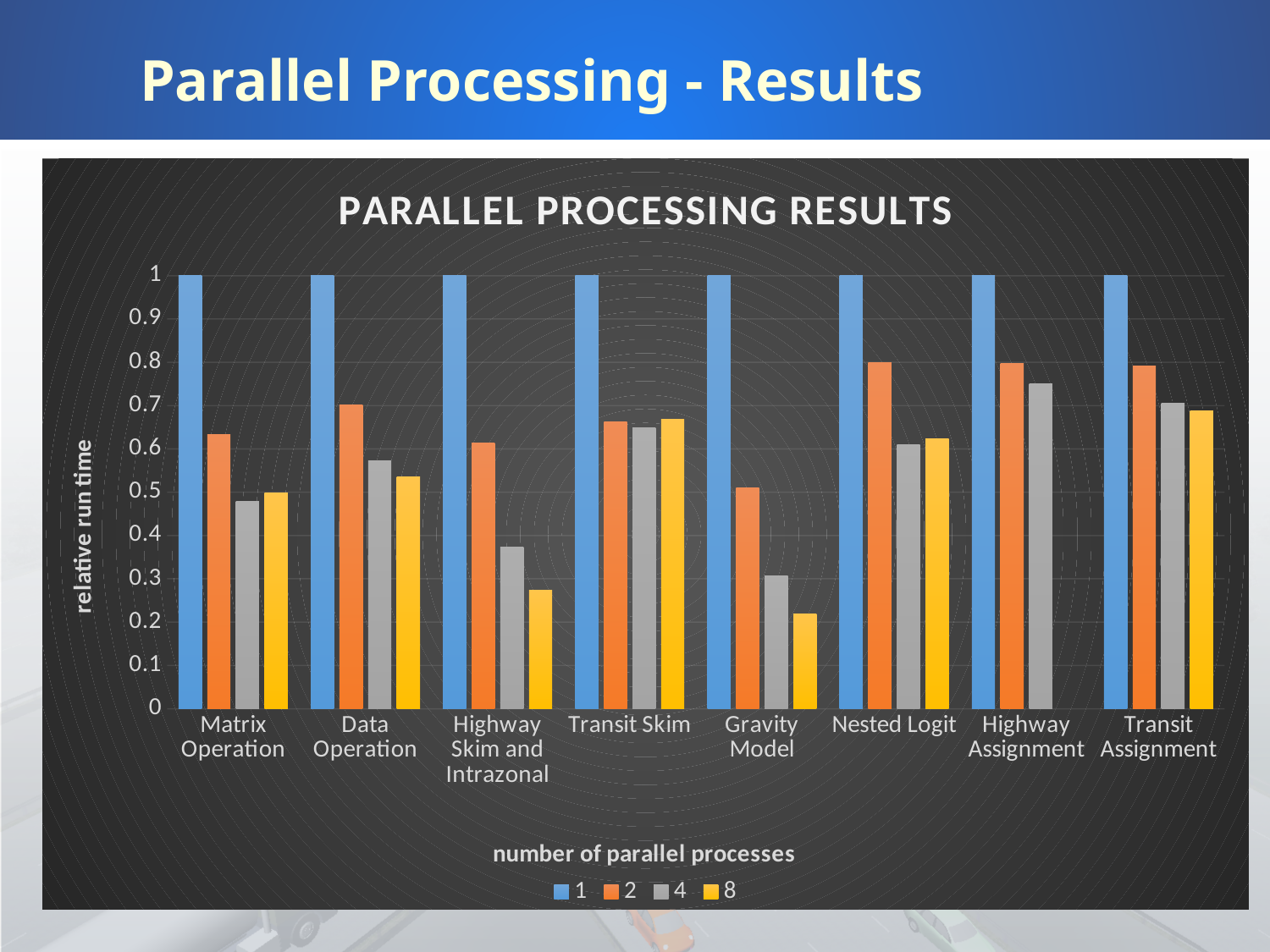
Is the relative run time for Highway Assignment with 4 parallel processes greater or less than 0.7? greater What kind of chart is shown on the slide? bar chart For Highway Skim and Intrazonal, does the relative run time rise or fall as the number of parallel processes increases from 1 to 8? fall Is the relative run time for Data Operation with 4 parallel processes greater or less than 0.5? greater Which category has the lowest relative run time with 8 parallel processes? Gravity Model What is the relative run time for Transit Assignment with 1 parallel process? 1 Which is larger: the relative run time for Gravity Model with 8 parallel processes or for Nested Logit with 8 parallel processes? Nested Logit What is the relative run time for Matrix Operation with 1 parallel process? 1 What is the label on the y axis of the chart? relative run time Is the relative run time for Gravity Model with 8 parallel processes greater or less than 0.3? less How many series does the legend list? 4 How many categories are shown along the x axis? 8